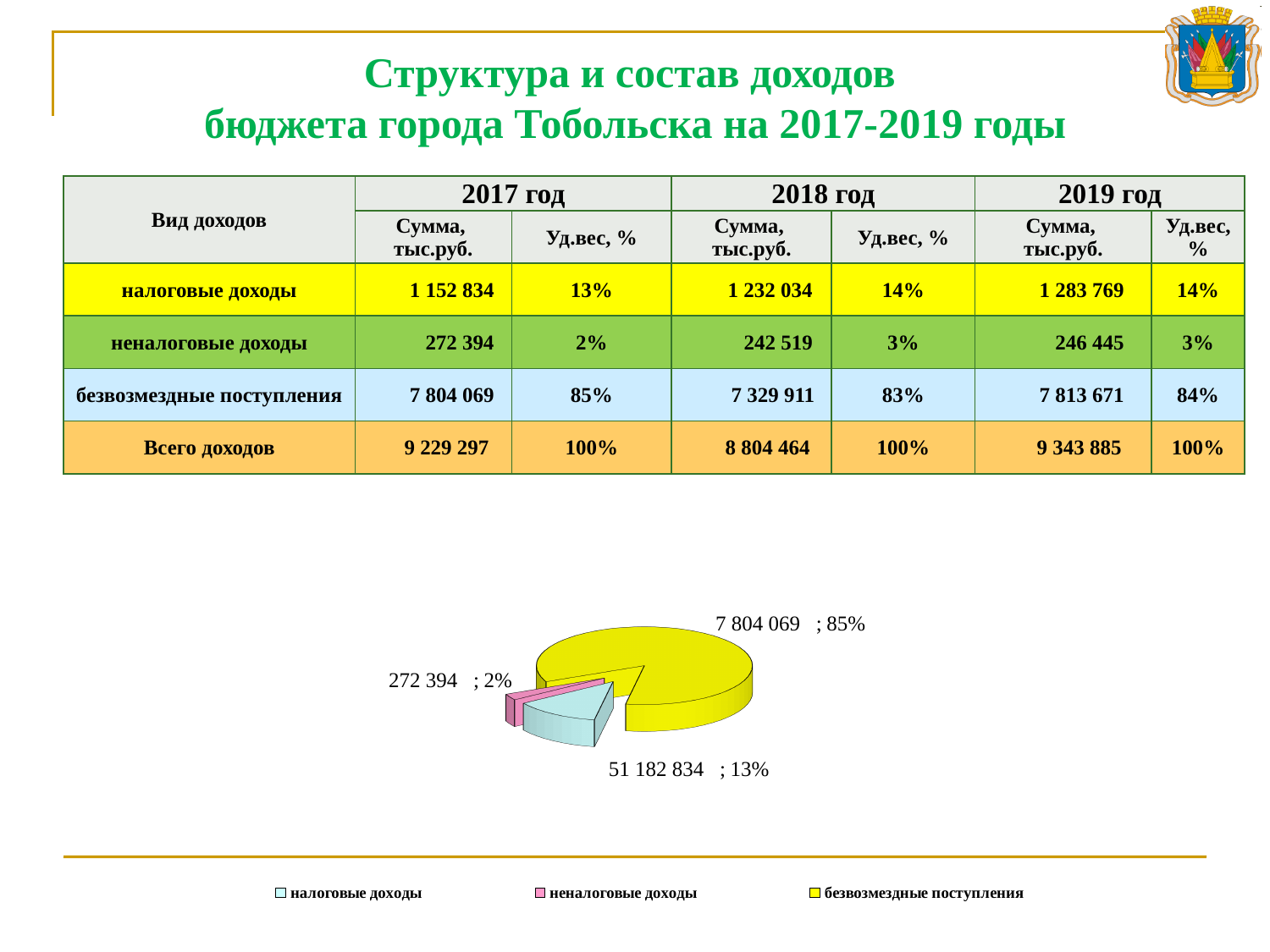
In the pie chart, what share is shown for неналоговые доходы? 2% In the pie chart, what value is labelled for неналоговые доходы? 272 394 In the pie chart, what share is shown for налоговые доходы? 13% In the pie chart, what is the difference in percentage points between the share of безвозмездные поступления and the share of неналоговые доходы? 83% Which slice of the pie chart is the smallest? неналоговые доходы How many slices does the pie chart have? 3 In the pie chart, which is larger: налоговые доходы or неналоговые доходы? налоговые доходы In the pie chart, what share is shown for безвозмездные поступления? 85% What kind of chart is shown on the slide? pie chart How many entries does the pie chart's legend list? 3 Which slice of the pie chart is the largest? безвозмездные поступления In the pie chart, what value is labelled for безвозмездные поступления? 7 804 069